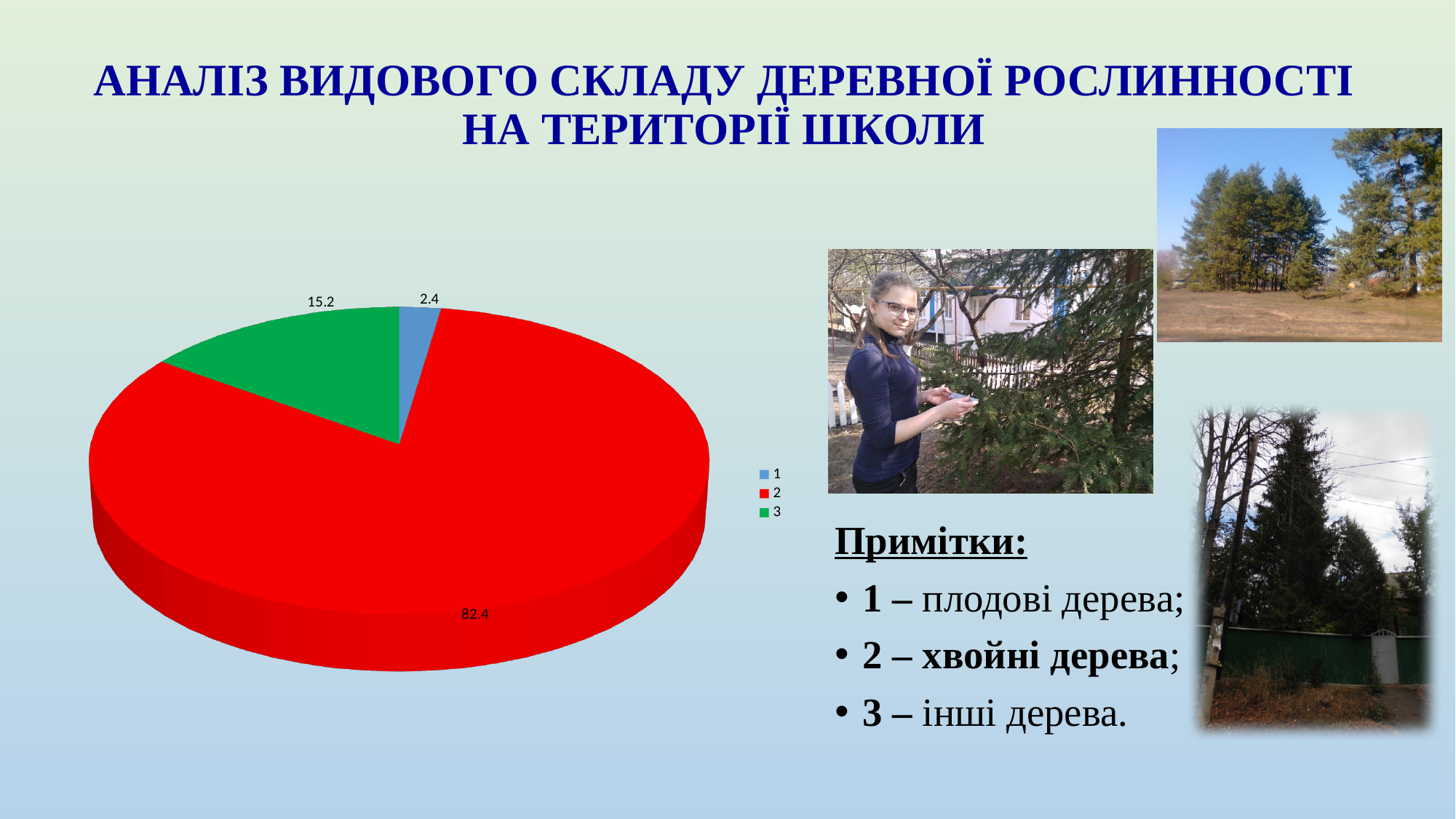
Which is larger, the value for category 3 or the value for category 1? 3 What is the difference between the values for category 2 and category 3? 67.2 Which category has the largest slice in the pie chart? 2 What type of chart is shown on the slide? pie chart How many slices does the pie chart have? 3 How many entries does the legend of the pie chart list? 3 What colour is the slice for category 2 in the pie chart? red What is the value shown for category 2 in the pie chart? 82.4 Which category has the smallest slice in the pie chart? 1 What is the value shown for category 1 in the pie chart? 2.4 What is the difference between the values for category 3 and category 1? 12.8 What is the value shown for category 3 in the pie chart? 15.2